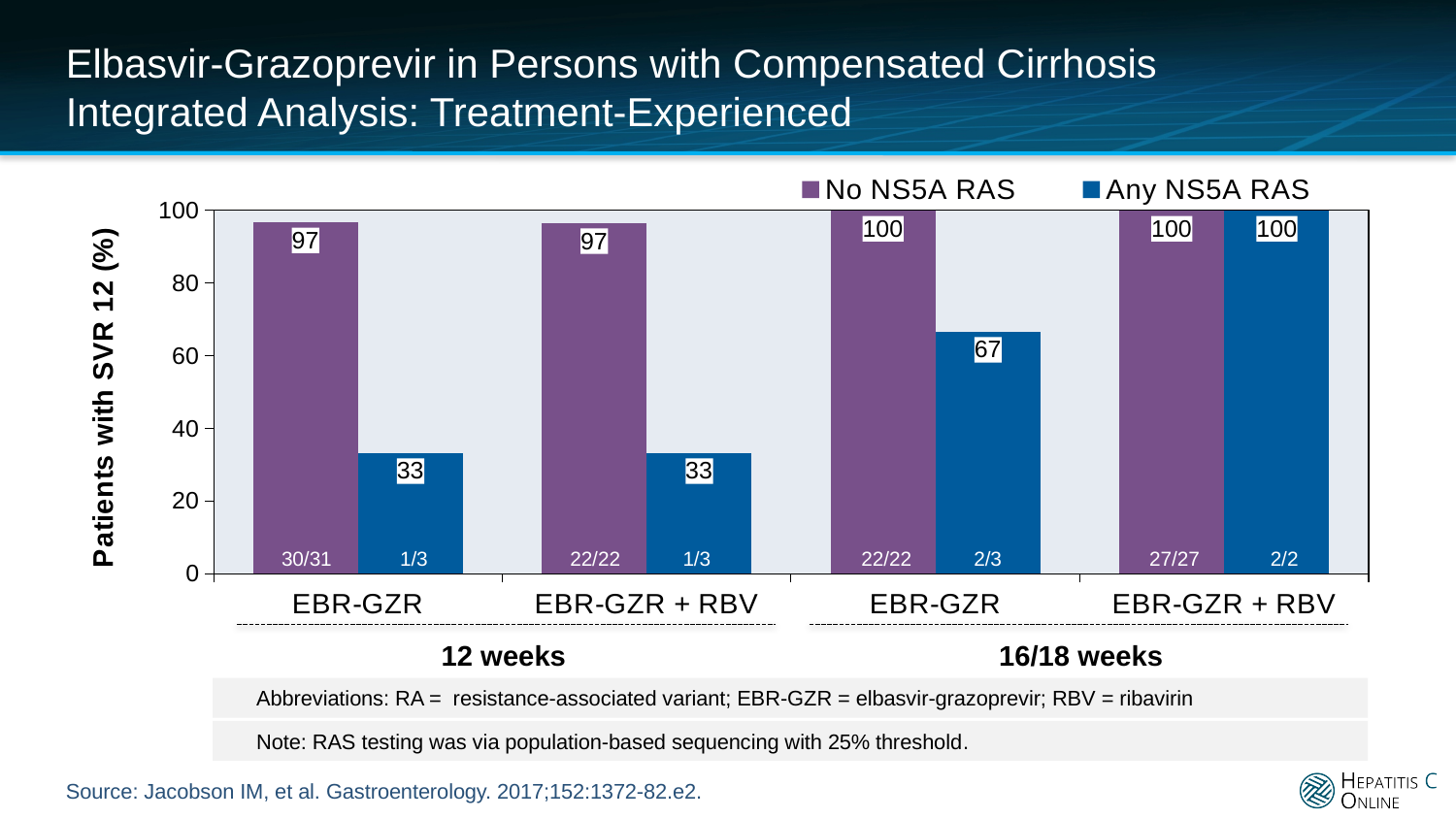
What fraction of patients is shown for the No NS5A RAS group with EBR-GZR at 12 weeks? 30/31 Which treatment group has the lowest SVR 12 rate for Any NS5A RAS patients? EBR-GZR and EBR-GZR + RBV at 12 weeks (33) What is the difference between the No NS5A RAS and Any NS5A RAS SVR 12 rates for EBR-GZR at 16/18 weeks? 33 How many treatment groups are shown on the x axis? 4 What fraction of patients is shown for the Any NS5A RAS group with EBR-GZR + RBV at 16/18 weeks? 2/2 What is the SVR 12 rate for the Any NS5A RAS group with EBR-GZR at 16/18 weeks? 67 Which is larger: the Any NS5A RAS SVR 12 rate for EBR-GZR at 16/18 weeks or for EBR-GZR at 12 weeks? EBR-GZR at 16/18 weeks What is the SVR 12 rate for the Any NS5A RAS group with EBR-GZR + RBV at 12 weeks? 33 What is the SVR 12 rate for the No NS5A RAS group with EBR-GZR at 12 weeks? 97 What kind of chart is shown on the slide? Bar chart How many series does the legend list? 2 Which colour represents the Any NS5A RAS series? Blue